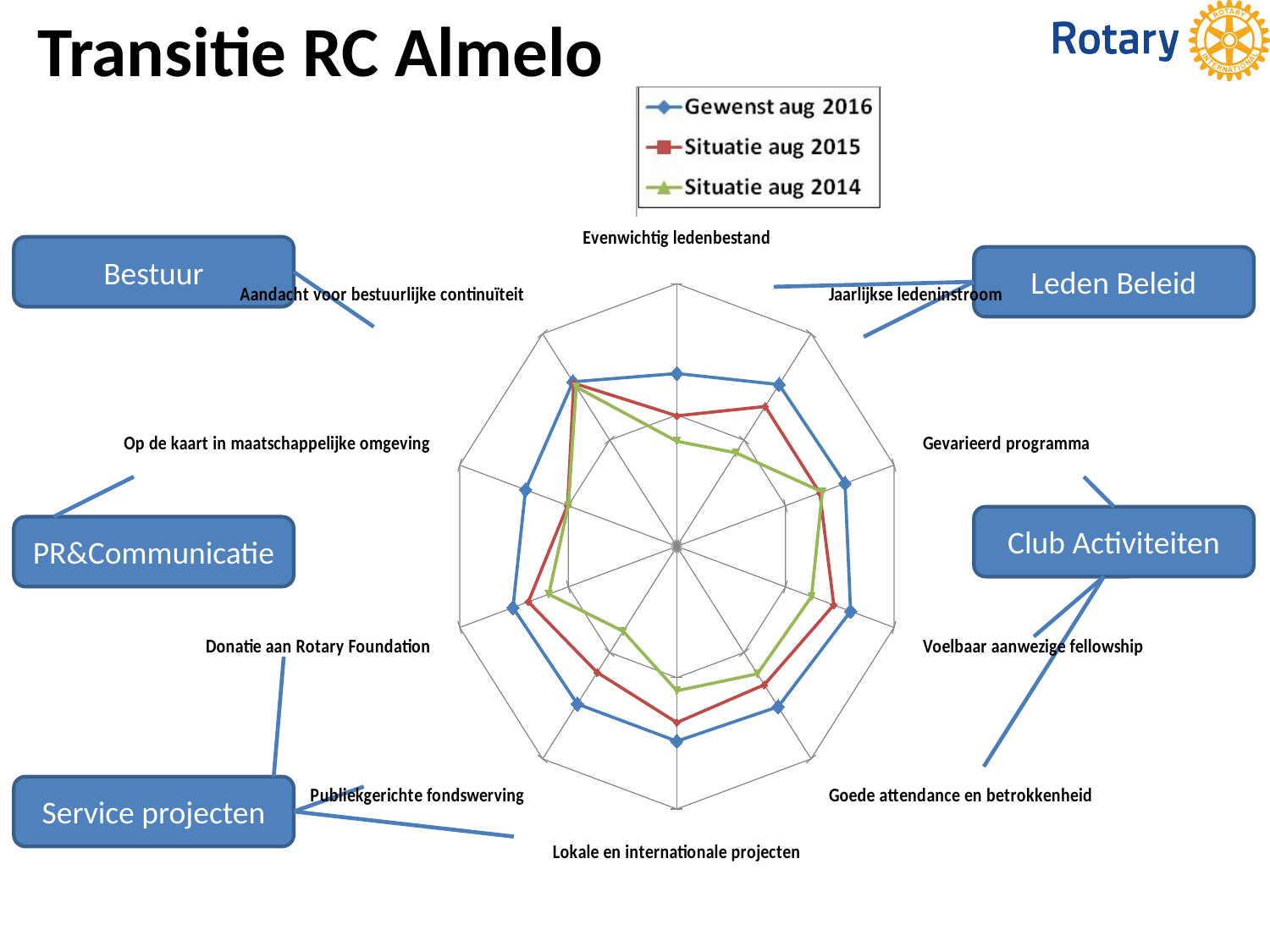
What kind of chart is shown on the slide? Radar chart Which series is shown with the green line in the chart? Situatie aug 2014 How many category axes does the radar chart have? 10 On the 'Lokale en internationale projecten' axis, which series has the larger value: Situatie aug 2015 or Situatie aug 2014? Situatie aug 2015 Which series forms the outermost line on the radar chart? Gewenst aug 2016 Which series is shown with the blue line in the chart? Gewenst aug 2016 How many series does the chart legend list? 3 On the 'Op de kaart in maatschappelijke omgeving' axis, which series has the larger value: Gewenst aug 2016 or Situatie aug 2015? Gewenst aug 2016 On the 'Gevarieerd programma' axis, which series has the larger value: Gewenst aug 2016 or Situatie aug 2014? Gewenst aug 2016